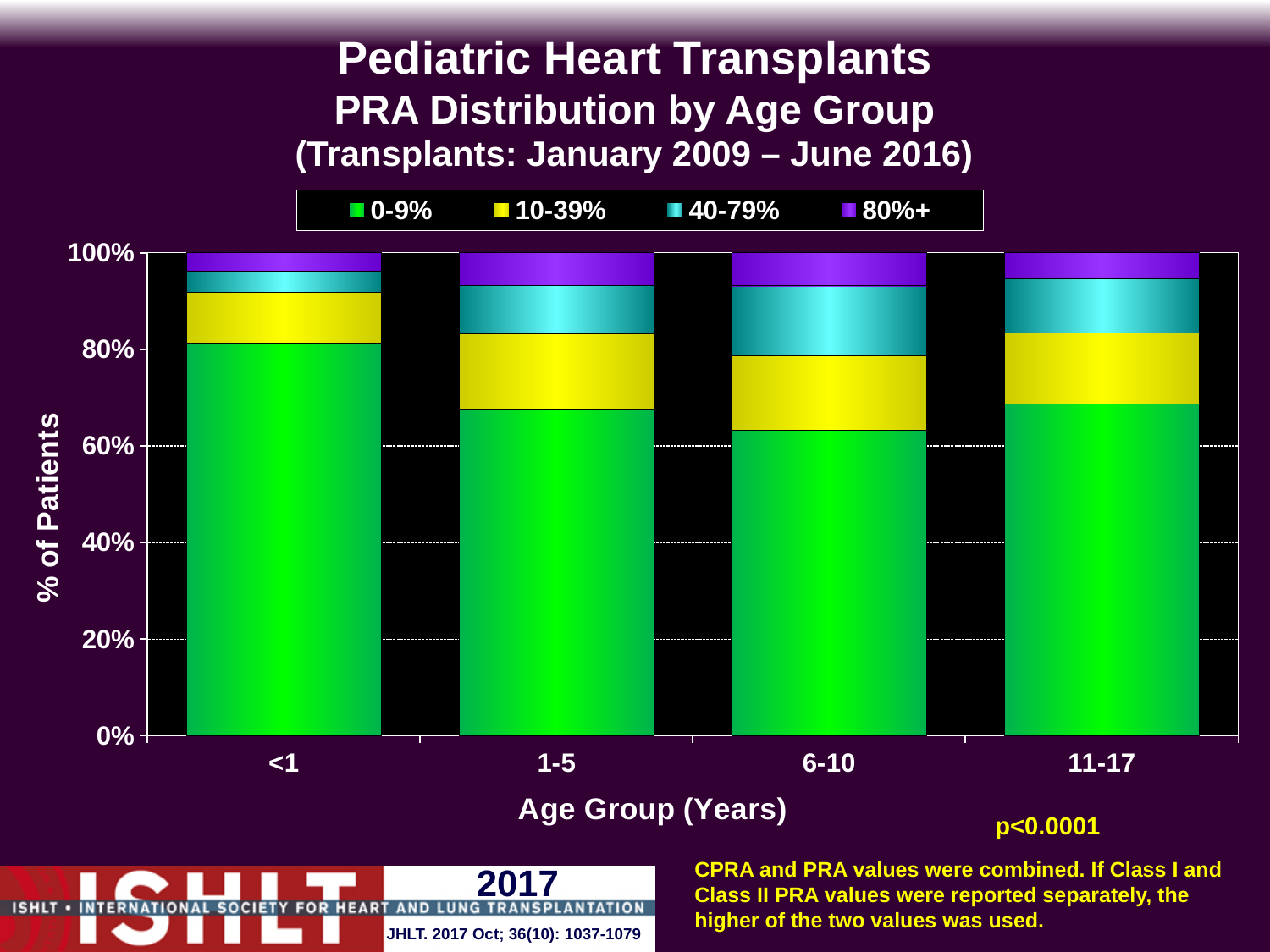
Is the 0-9% PRA share for the 6-10 age group greater or less than 80%? less Is the 0-9% PRA segment larger for the <1 age group or the 6-10 age group? <1 Which age group has the smallest 0-9% PRA segment? 6-10 What is the total height of the stacked bar for the 11-17 age group? 100% How many PRA categories does the legend list? 4 Is the 0-9% PRA share for the 1-5 age group greater or less than 60%? greater Which colour represents the 80%+ PRA category in the legend? Purple Is the 0-9% PRA share for the <1 age group greater or less than 60%? greater What is the label on the y axis? % of Patients What kind of chart is shown on the slide? Stacked bar chart How many age groups are shown on the x axis? 4 Which age group has the largest 0-9% PRA segment? <1